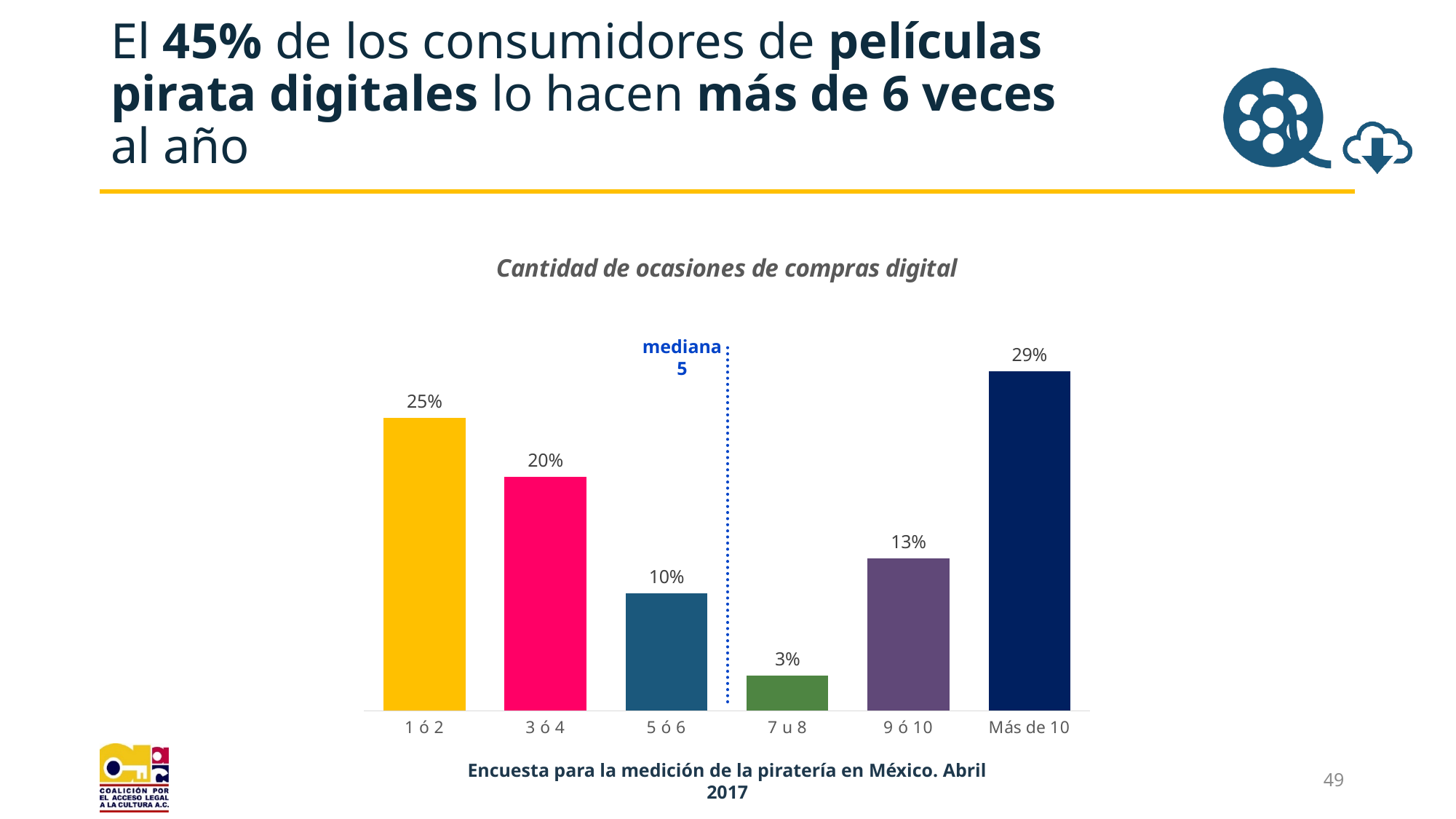
What is the title of the chart? Cantidad de ocasiones de compras digital What is the value for the '1 ó 2' category? 25% Which category has the lowest value? 7 u 8 What is the value for the '9 ó 10' category? 13% What is the value for the '7 u 8' category? 3% What is the value for the 'Más de 10' category? 29% What value is marked by the dotted 'mediana' line on the chart? 5 Which category has the highest value? Más de 10 What is the difference between the values for '1 ó 2' and '3 ó 4'? 5% How many categories are shown on the x axis? 6 Which is larger, the value for '5 ó 6' or the value for '9 ó 10'? 9 ó 10 What kind of chart is shown on the slide? Bar chart